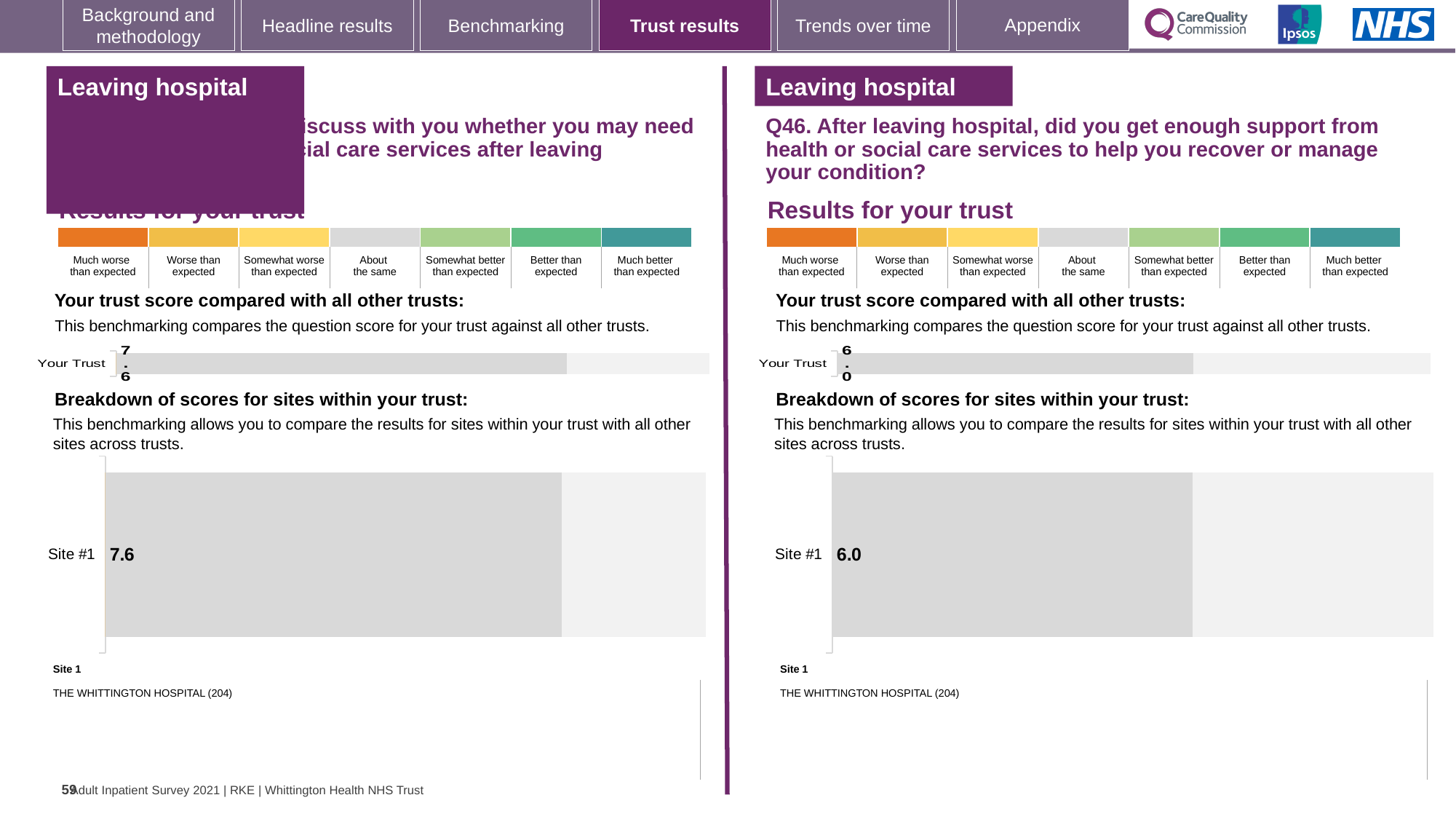
On the left-hand chart, what is the score shown for Site #1 in the breakdown of scores for sites within your trust? 7.6 On the right-hand chart (Q46), what is the score shown for Site #1 in the breakdown of scores for sites within your trust? 6.0 How many sites are shown in the breakdown of scores chart on the right-hand side (Q46)? 1 What kind of chart is used for the breakdown of scores for sites within your trust on the left-hand side? Bar chart How many rating categories are shown in the colour scale under 'Results for your trust' on the right-hand side (Q46)? 7 On the left-hand chart, what is the 'Your Trust' score in the trust comparison bar? 7.6 Which Site #1 score is larger: the one on the left-hand chart or the one on the right-hand chart (Q46)? The left-hand chart (7.6) What is the difference between the Site #1 score on the left-hand chart and the Site #1 score on the right-hand chart (Q46)? 1.6 On the right-hand chart (Q46), what is the 'Your Trust' score in the trust comparison bar? 6.0 On the right-hand chart (Q46), which hospital is listed as Site 1? THE WHITTINGTON HOSPITAL (204)